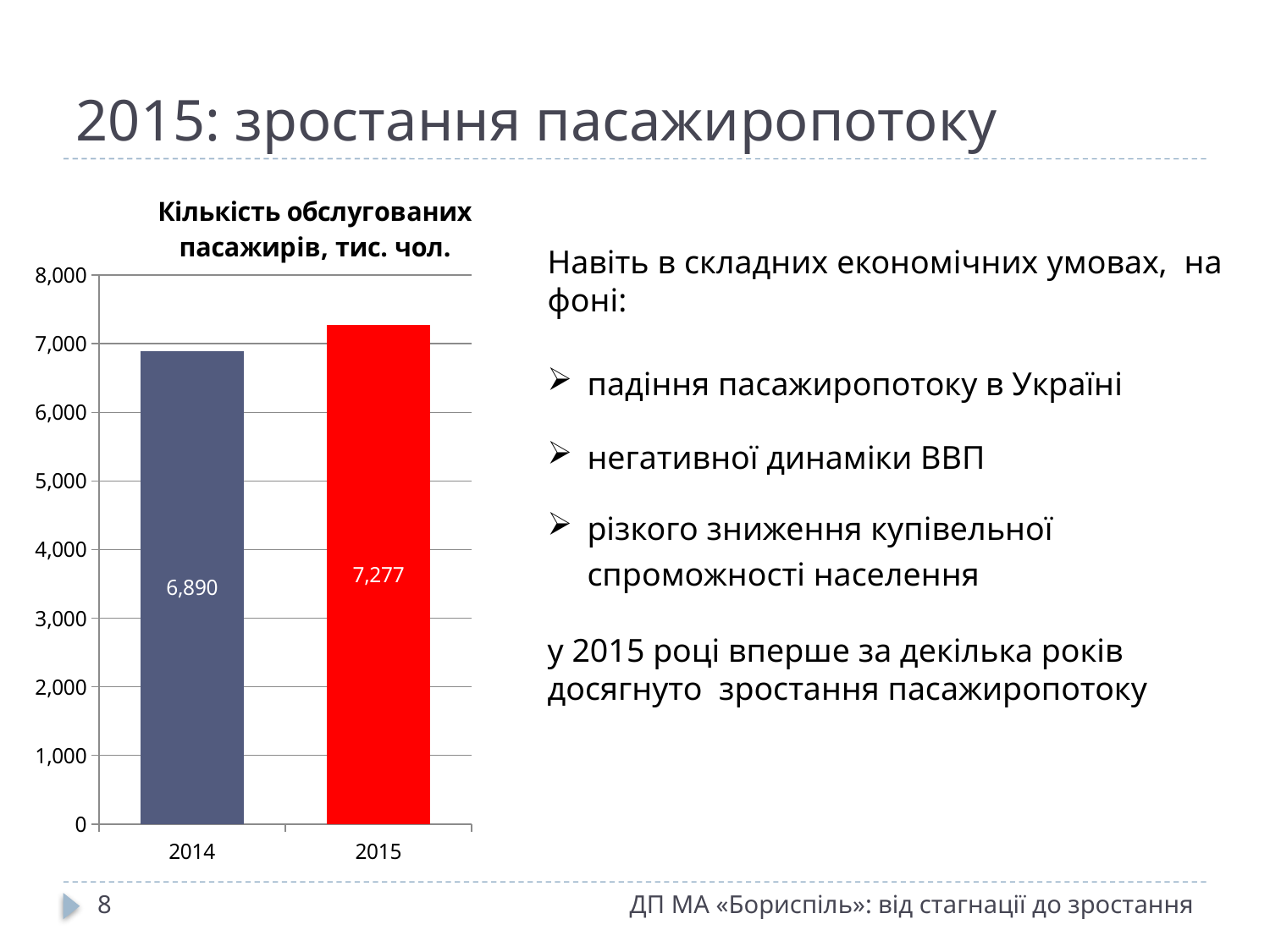
What kind of chart is shown on the slide? bar chart Is the value for 2014 greater or less than 7,000? less What is the value for 2015 in the chart? 7,277 Is the value for 2015 greater or less than 7,000? greater Is the value for 2014 greater or less than the value for 2015? less How many categories (years) are shown in the chart? 2 What is the difference between the 2015 and 2014 values in the chart? 387 Which year has the higher value in the chart? 2015 What is the value for 2014 in the chart? 6,890 Do the values rise or fall from 2014 to 2015? rise Which year has the lower value in the chart? 2014 What is the title of the chart? Кількість обслугованих пасажирів, тис. чол.